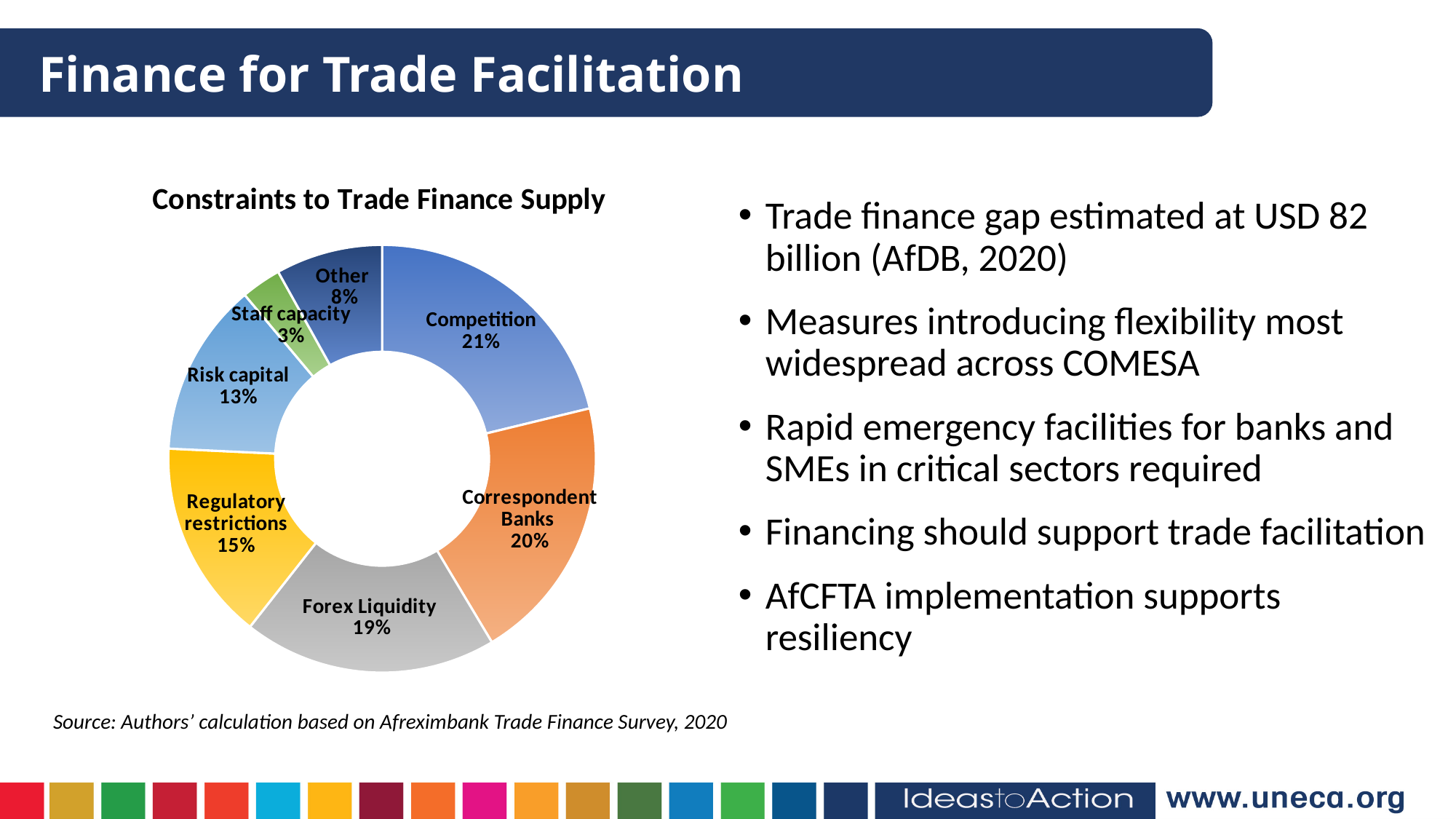
What share of the chart does Competition account for? 21% Which is larger, the share for Forex Liquidity or the share for Regulatory restrictions? Forex Liquidity What is the value shown for Forex Liquidity? 19% Which constraint has the largest share in the chart? Competition What is the value for Staff capacity? 3% Which constraint has the smallest share in the chart? Staff capacity What is the title of the chart? Constraints to Trade Finance Supply What kind of chart is shown on the slide? Doughnut (pie) chart What is the combined share of Other and Staff capacity? 11% What percentage is shown for Regulatory restrictions? 15% What is the difference in percentage points between Correspondent Banks and Risk capital? 7 How many categories are shown in the chart? 7